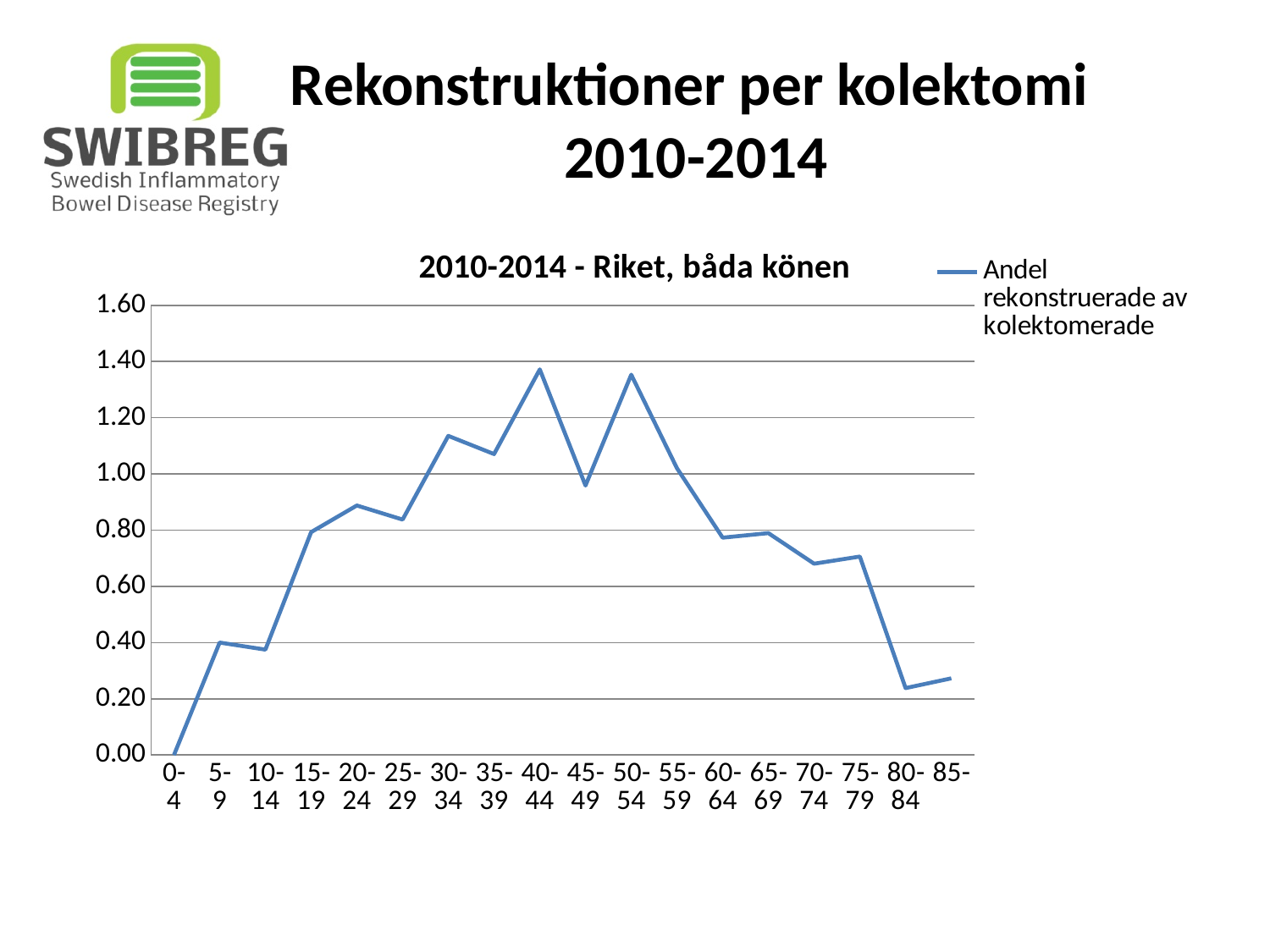
What is the value for the 0-4 age group? 0.00 What is the title of the chart? 2010-2014 - Riket, båda könen Is the value for the 70-74 age group greater or less than 0.60? greater What kind of chart is shown on the slide? line chart How many age groups are plotted along the x axis? 18 Do the values rise or fall from the 50-54 age group to the 80-84 age group? fall Which age group has the lowest value? 0-4 Is the value for the 80-84 age group greater or less than 0.40? less Is the value for the 30-34 age group greater or less than 1.00? greater Which has the larger value, the 40-44 age group or the 45-49 age group? 40-44 How many series does the legend list? 1 What is the legend entry for the plotted line? Andel rekonstruerade av kolektomerade